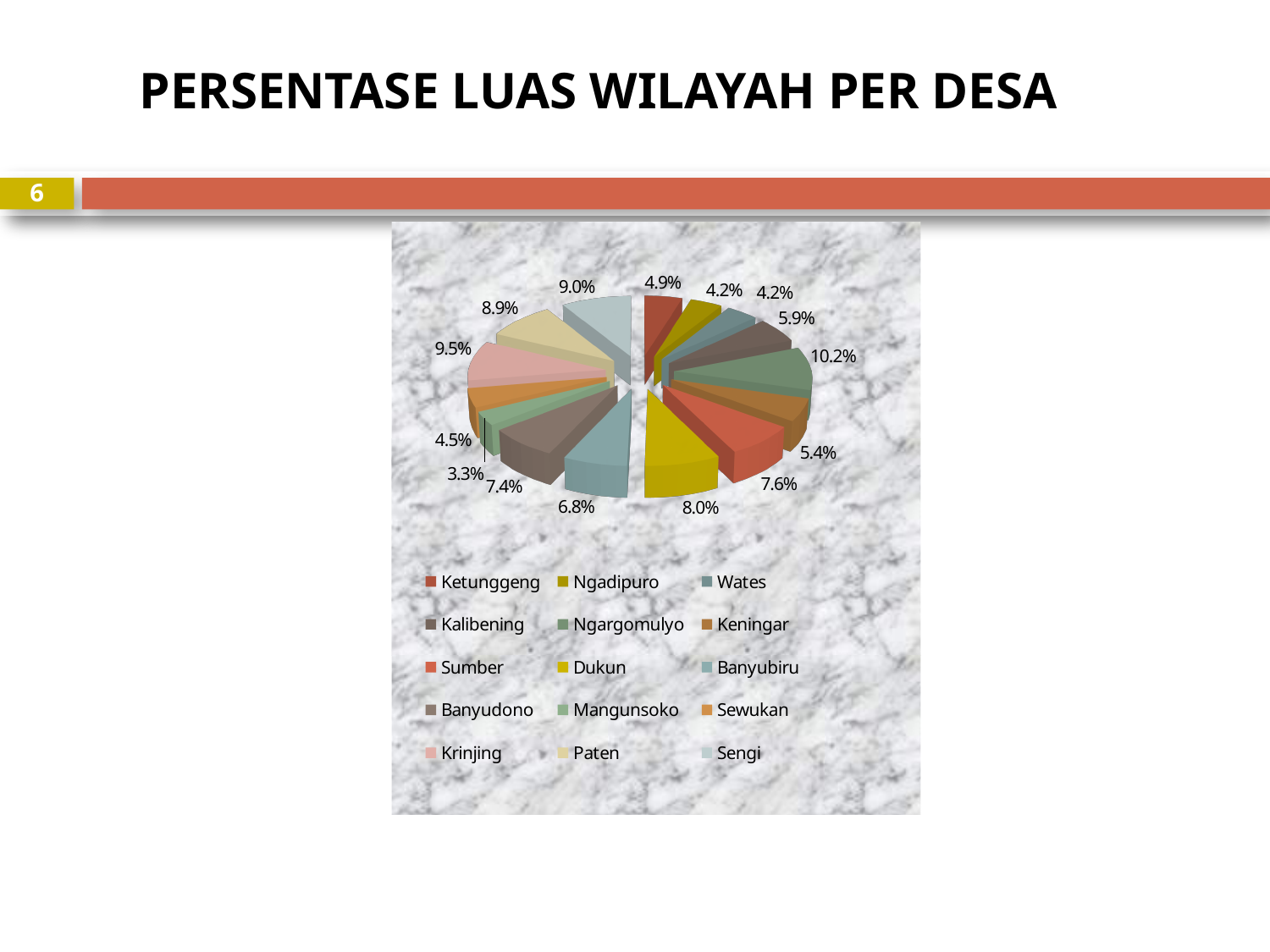
Which has a larger share, Sumber (7.6%) or Banyubiru (6.8%)? Sumber What is the title of the slide containing the pie chart? PERSENTASE LUAS WILAYAH PER DESA What percentage of the area does Dukun account for? 8.0% What is the largest percentage shown on the pie chart? 10.2% Which village has the smallest share of the area in the pie chart? Mangunsoko What percentage of the area does Ketunggeng account for? 4.9% What type of chart is shown on the slide? pie chart What is the smallest percentage shown on the pie chart? 3.3% What percentage of the area does Krinjing account for? 9.5% How many slices (villages) does the pie chart have? 15 Which village has the largest share of the area in the pie chart? Ngargomulyo What is the difference in percentage points between the largest slice (10.2%) and the smallest slice (3.3%)? 6.9